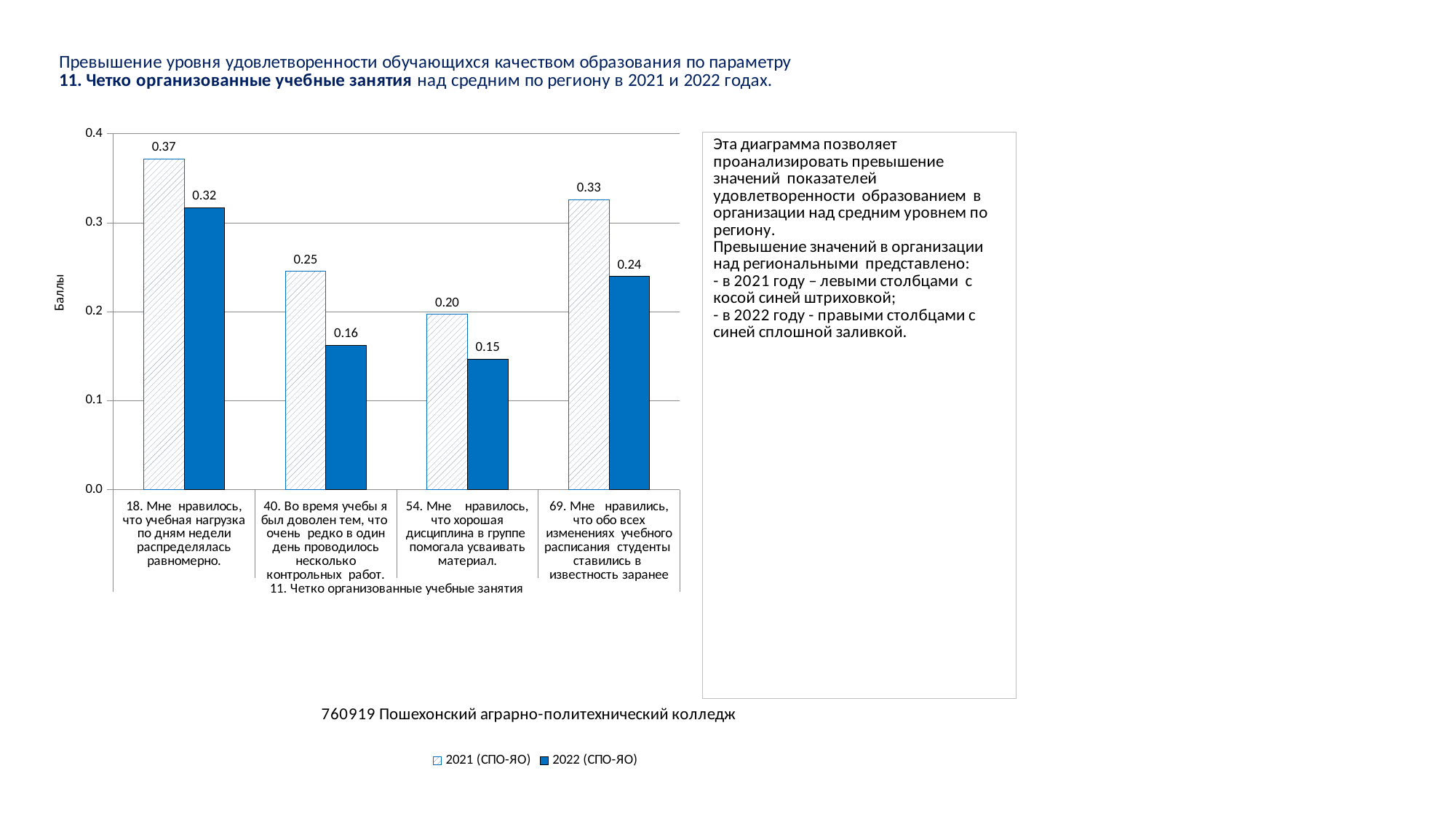
Which is larger for category 69: the 2021 (СПО-ЯО) value or the 2022 (СПО-ЯО) value? 2021 (СПО-ЯО) What kind of chart is shown on the slide? bar chart Which category has the lowest 2022 (СПО-ЯО) value? 54. Мне нравилось, что хорошая дисциплина в группе помогала усваивать материал. Is the 2021 (СПО-ЯО) value for category 54 greater or less than 0.3? less Which category has the highest 2021 (СПО-ЯО) value? 18. Мне нравилось, что учебная нагрузка по дням недели распределялась равномерно. What is the 2022 (СПО-ЯО) value for category 69 ("Мне нравились, что обо всех изменениях учебного расписания студенты ставились в известность заранее")? 0.24 What is the 2022 (СПО-ЯО) value for category 54 ("Мне нравилось, что хорошая дисциплина в группе помогала усваивать материал")? 0.15 How many series does the chart legend list? 2 How many categories are shown on the x axis of the chart? 4 What is the difference between the 2021 and 2022 values for category 40 ("Во время учебы я был доволен тем, что очень редко в один день проводилось несколько контрольных работ")? 0.09 What is the 2021 (СПО-ЯО) value for category 18 ("Мне нравилось, что учебная нагрузка по дням недели распределялась равномерно")? 0.37 What is the label of the vertical axis of the chart? Баллы